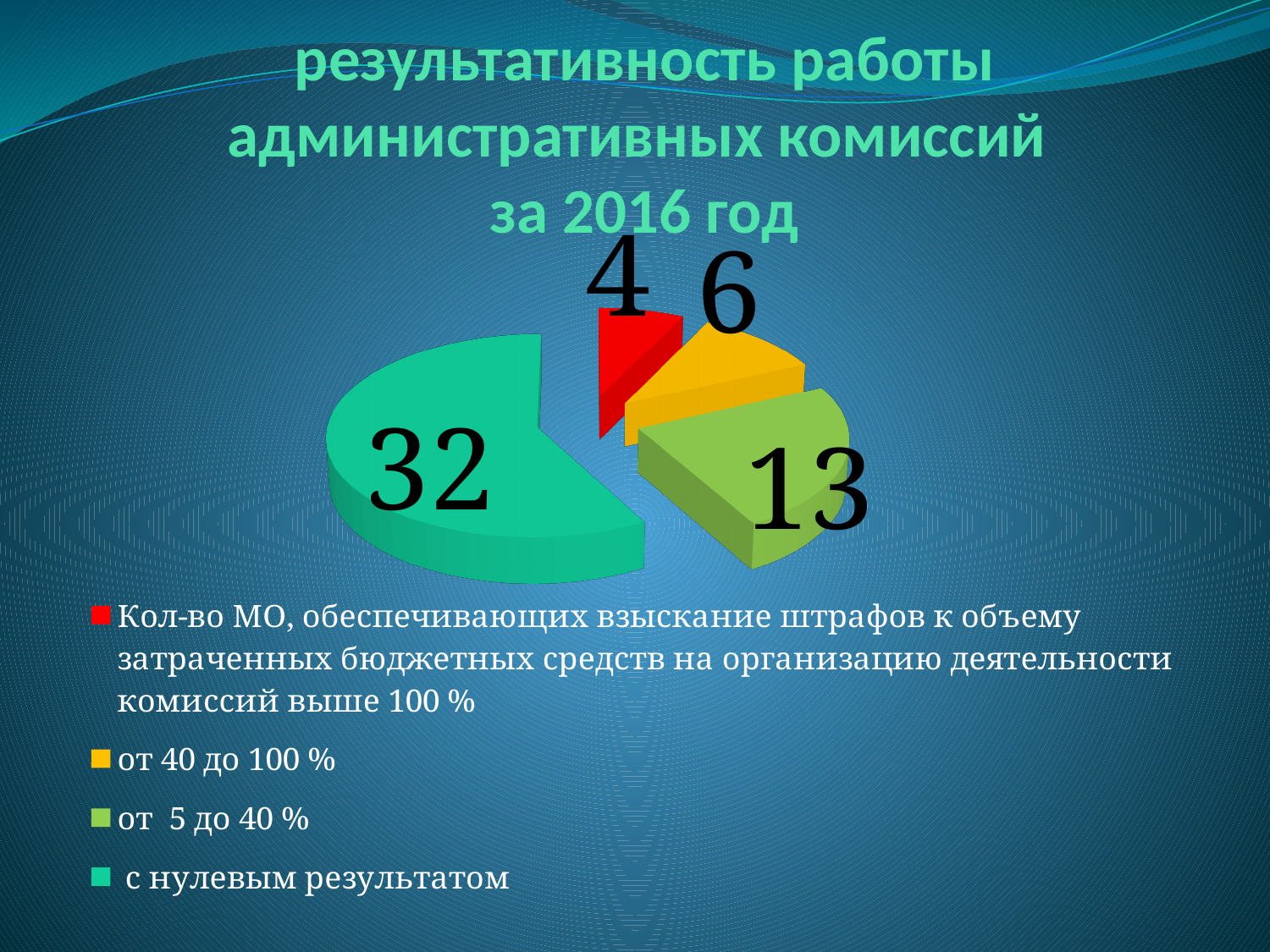
What colour is the slice for "с нулевым результатом"? Teal (green) What kind of chart is shown on the slide? Pie chart What is the value of the slice for "с нулевым результатом"? 32 What is the difference between the values for "с нулевым результатом" and "от 5 до 40 %"? 19 What is the total of all slices in the pie chart? 55 What is the value of the red slice ("выше 100 %")? 4 What is the value of the slice for "от 5 до 40 %"? 13 Which category has the smallest slice in the pie chart? Кол-во МО, обеспечивающих взыскание штрафов к объему затраченных бюджетных средств на организацию деятельности комиссий выше 100 % What is the value of the slice for "от 40 до 100 %"? 6 Which category has the largest slice in the pie chart? с нулевым результатом Which is larger: the value for "от 40 до 100 %" or the value for "от 5 до 40 %"? от 5 до 40 % How many slices does the pie chart have? 4